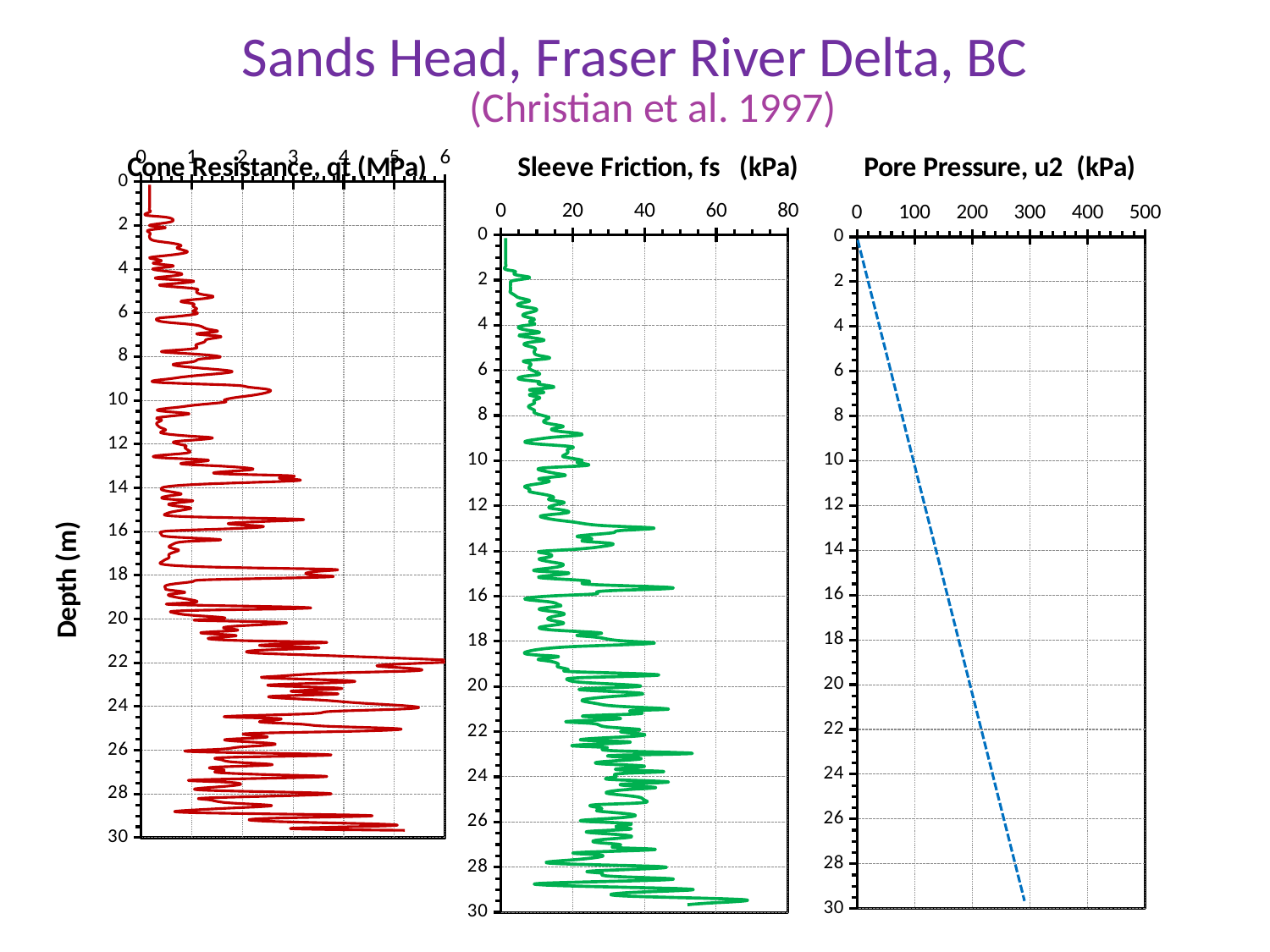
In the Cone Resistance, qt (MPa) chart, is the cone resistance at a depth of 22 m larger or smaller than at a depth of 2 m? larger What kind of chart is the Cone Resistance, qt (MPa) chart on the left? line chart In the Cone Resistance, qt (MPa) chart, is the peak value near a depth of 22 m greater or less than 5 MPa? greater In the Cone Resistance, qt (MPa) chart, is the value at a depth of 2 m greater or less than 1 MPa? less In the Pore Pressure, u2 (kPa) chart, does the pore pressure rise or fall as depth increases from 0 to 30 m? rise In the Pore Pressure, u2 (kPa) chart, is the value at a depth of 30 m greater or less than 400 kPa? less What colour is the line plotted in the Sleeve Friction, fs (kPa) chart? green What kind of chart is the Pore Pressure, u2 (kPa) chart on the right? line chart What is the label on the vertical axis of the Cone Resistance, qt (MPa) chart? Depth (m)